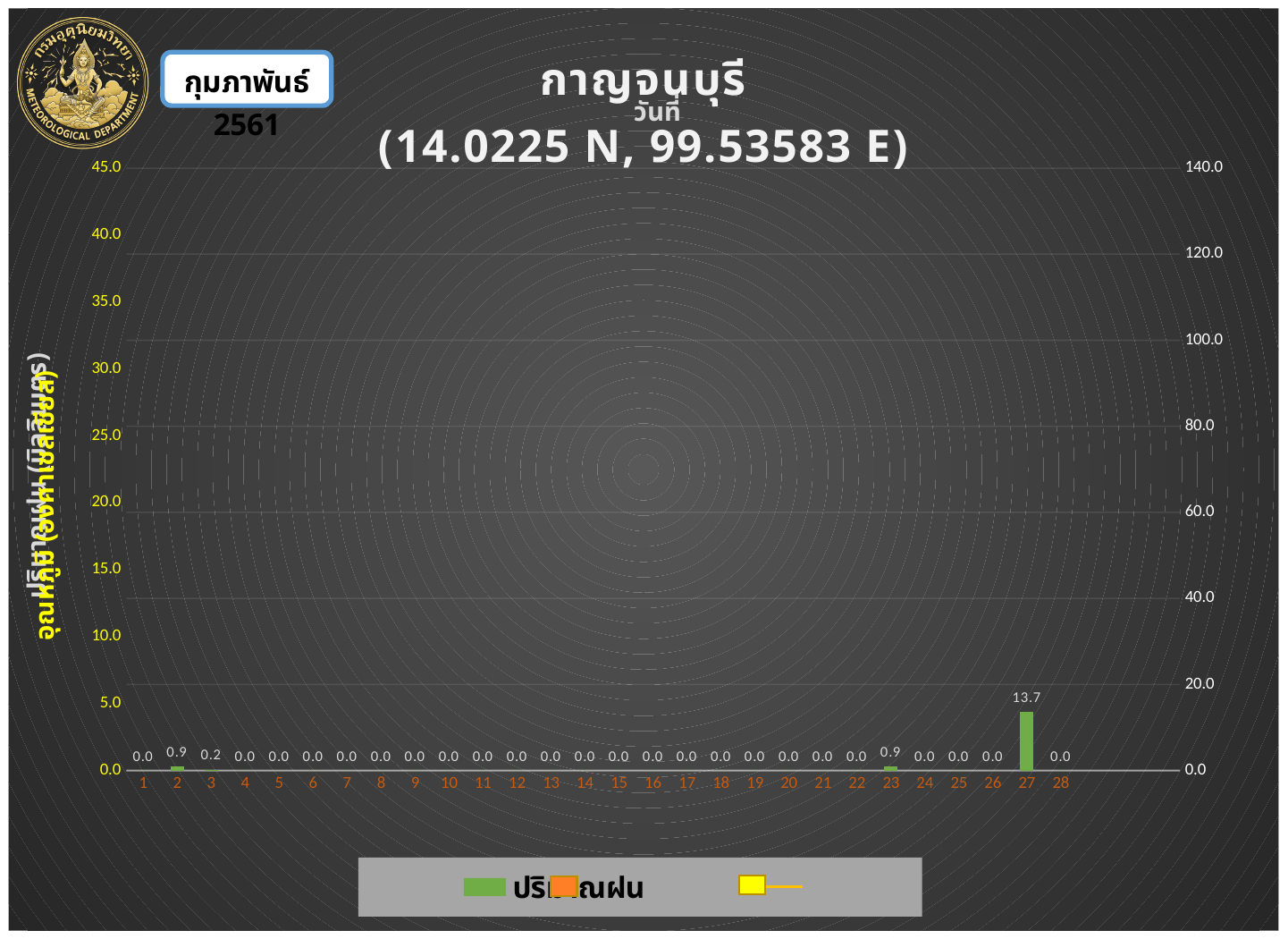
How many days are shown on the x axis? 28 What is the highest tick value on the right-hand axis? 140.0 Which has the larger value, day 2 or day 3? Day 2 What coordinates are given in the chart title? 14.0225 N, 99.53583 E What is the difference between the values for day 27 and day 23? 12.8 What is the value shown for day 3? 0.2 What is the rainfall value plotted for day 27? 13.7 What is the value shown for day 2? 0.9 What is the value shown for day 23? 0.9 Which day has the highest plotted value? 27 What kind of chart is shown on the slide? Bar chart